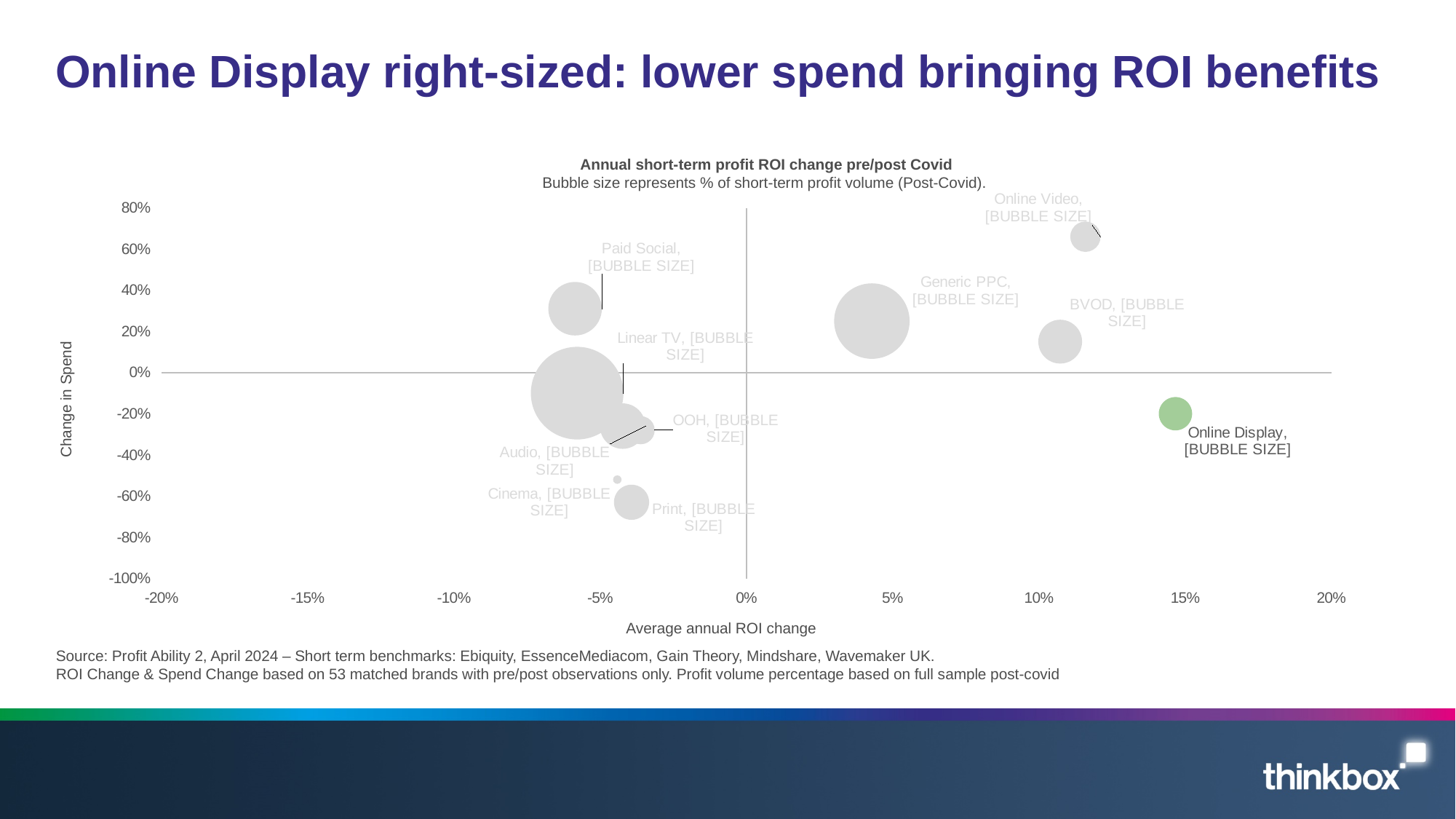
Which channel has the lowest change in spend? Print Which channel has the highest average annual ROI change? Online Display Is the change in spend for Print greater or less than -40%? less Which has the larger change in spend, Online Video or Online Display? Online Video Which bubble is highlighted in green on the chart? Online Display Which channel has the highest change in spend? Online Video Is the average annual ROI change for Online Display greater or less than 10%? greater Is the change in spend for Paid Social greater or less than 20%? greater Which channel has the largest bubble (largest share of short-term profit volume)? Linear TV What kind of chart is shown on the slide? Bubble chart How many media channels (bubbles) are plotted on the chart? 10